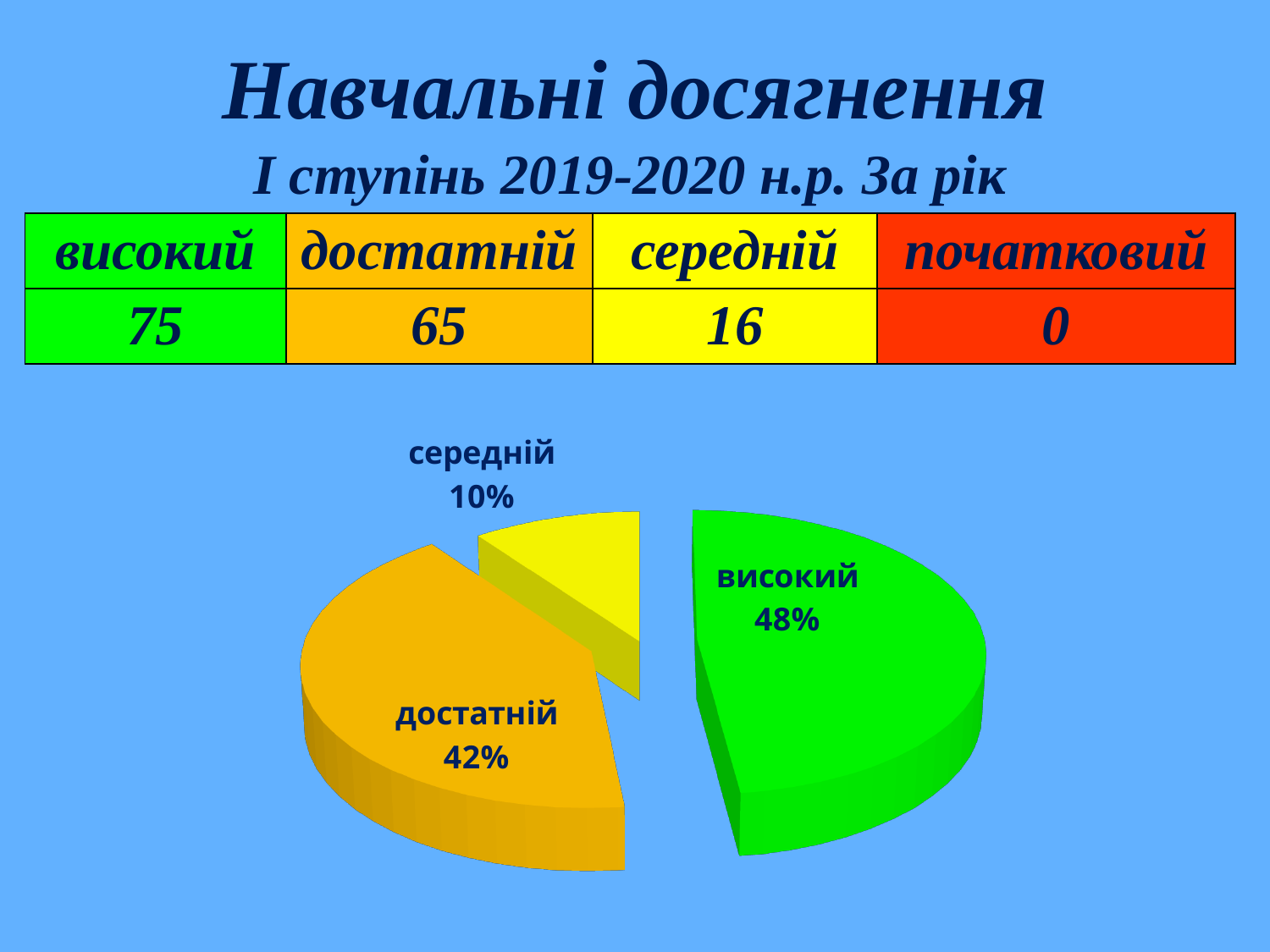
Which slice of the pie chart is the smallest? середній How many slices does the pie chart have? 3 What share of the pie does the середній slice represent? 10% Which slice of the pie chart is the largest? високий What is the difference in percentage points between the достатній slice and the середній slice? 32% What is the difference in percentage points between the високий slice and the достатній slice? 6% Which is larger in the pie chart, the достатній slice or the середній slice? достатній What colour is the високий slice in the pie chart? green What kind of chart is shown on the slide? pie chart What share of the pie does the достатній slice represent? 42% What share of the pie does the високий slice represent? 48% What colour is the середній slice in the pie chart? yellow